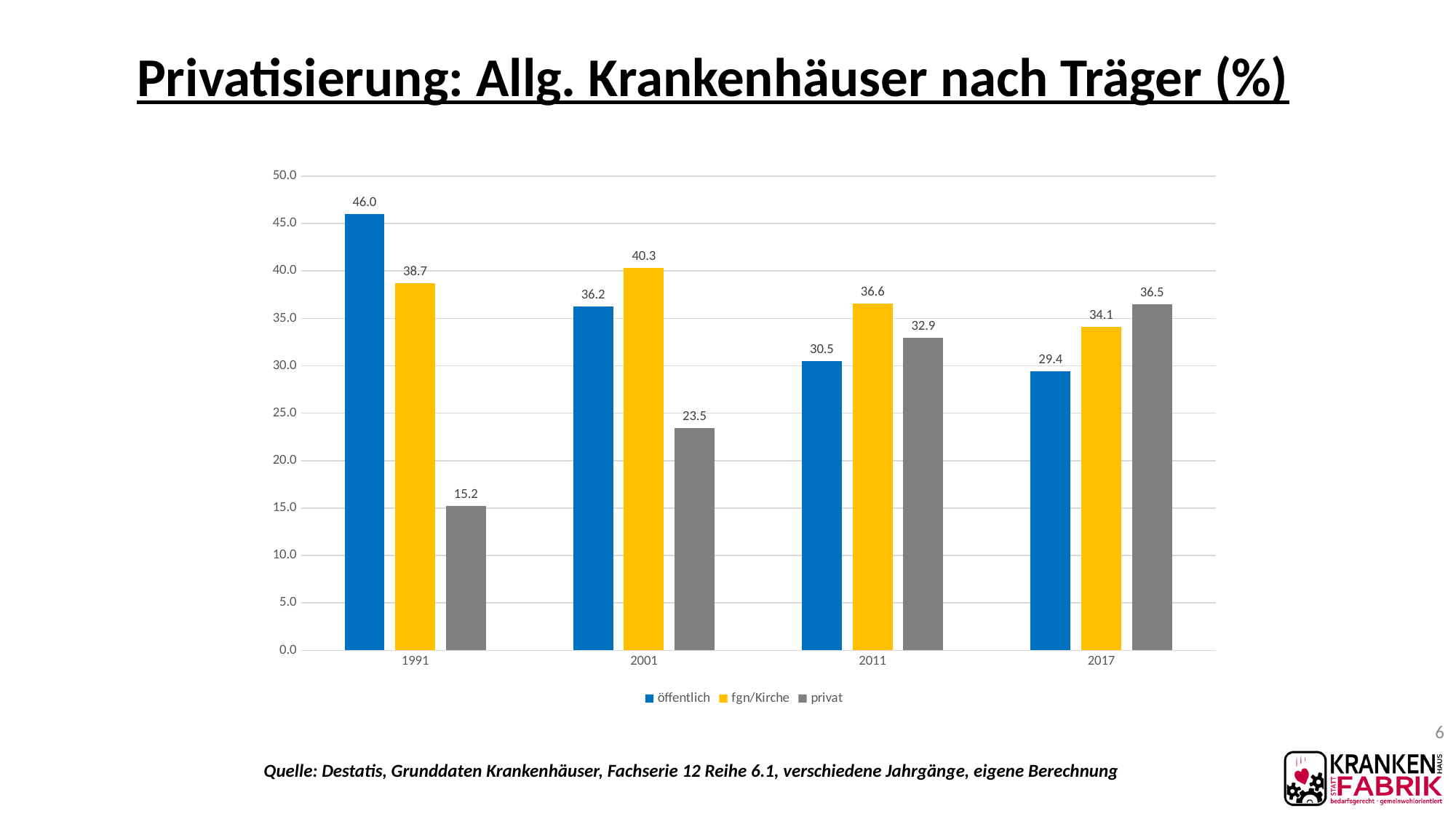
How many series does the legend list? 3 What is the value for fgn/Kirche in 2001? 40.3 Which colour represents the privat series? grey Does the privat series rise or fall from 1991 to 2017? rise What kind of chart is shown? bar chart How many years are shown on the x axis? 4 In which year is the privat series lowest? 1991 What is the value for öffentlich in 1991? 46.0 Which is larger in 2011: fgn/Kirche or privat? fgn/Kirche What is the value for privat in 2017? 36.5 In which year is the öffentlich series highest? 1991 What is the difference between the öffentlich value in 1991 and in 2017? 16.6